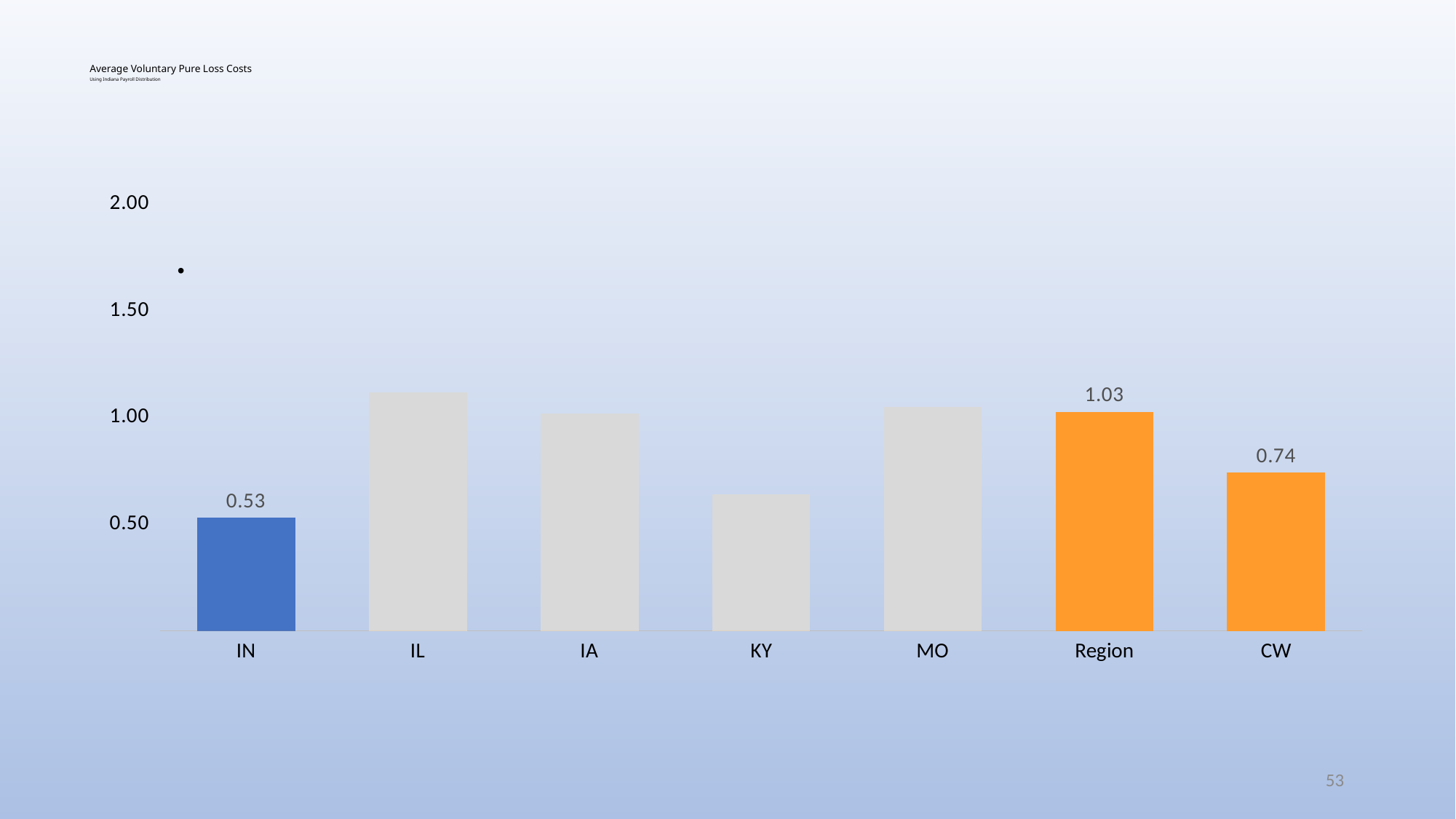
What is the difference between the values for Region and CW? 0.29 Which category has the highest value? IL Is the value for IL greater or less than 1.00? greater Which category has the lowest value? IN What is the value for IN? 0.53 Which is larger, the value for Region or the value for CW? Region What is the value for CW? 0.74 How many categories are shown on the x axis? 7 Is the value for KY greater or less than 1.00? less What is the value for Region? 1.03 What is the difference between the values for Region and IN? 0.50 What is the title of the chart? Average Voluntary Pure Loss Costs